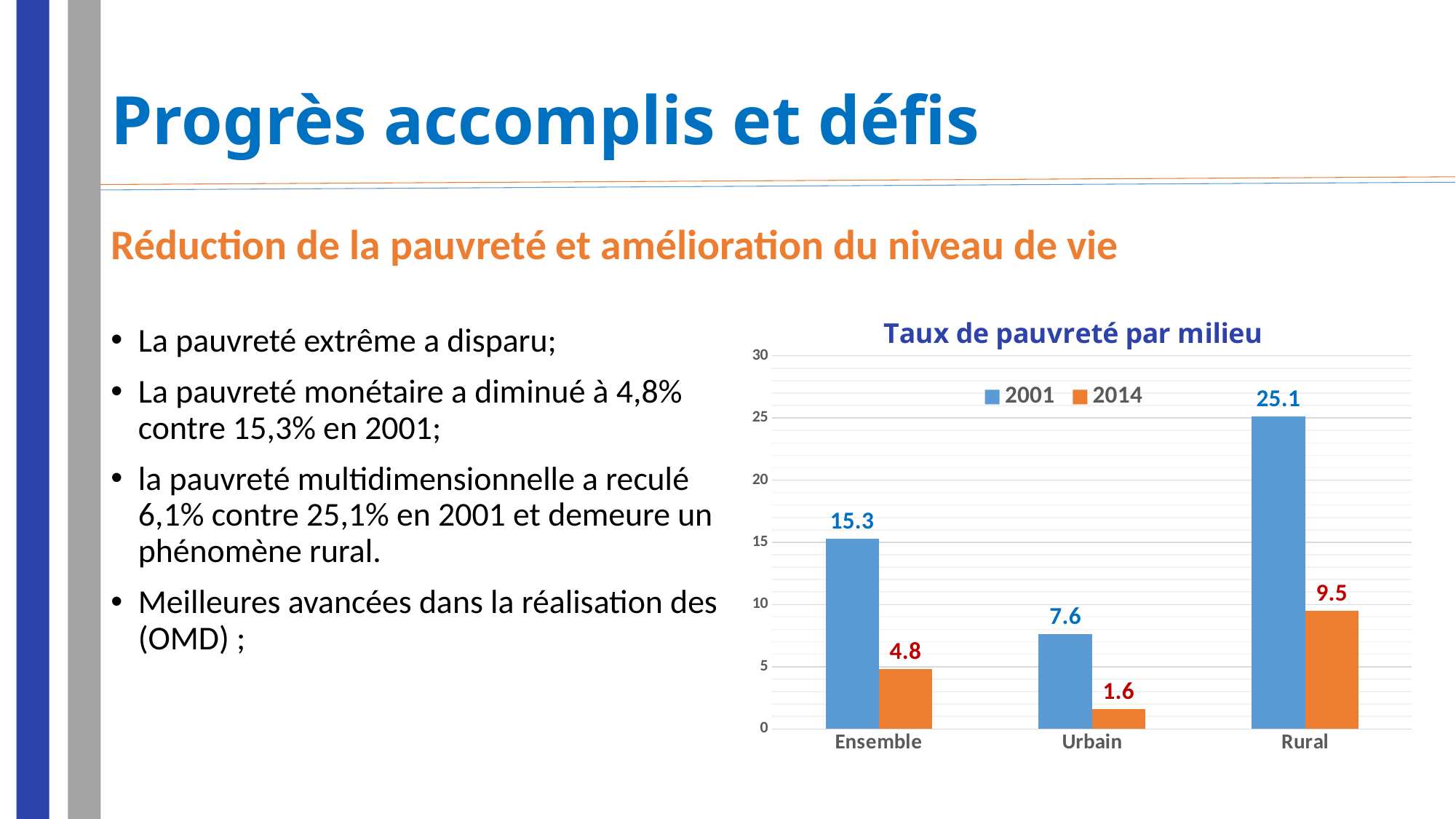
Which category has the highest value for 2001? Rural How many series does the legend list? 2 What is the value for Urbain in 2014? 1.6 Is the value for Rural in 2001 greater or less than 20? greater How many categories are shown on the x axis? 3 What is the title of the chart? Taux de pauvreté par milieu What is the value for Rural in 2014? 9.5 Which category has the lowest value for 2014? Urbain What is the difference between the 2001 values for Ensemble and Urbain? 7.7 What is the value for Ensemble in 2001? 15.3 What is the difference between the 2001 and 2014 values for Rural? 15.6 Which is larger: the 2014 value for Ensemble or the 2014 value for Rural? Rural